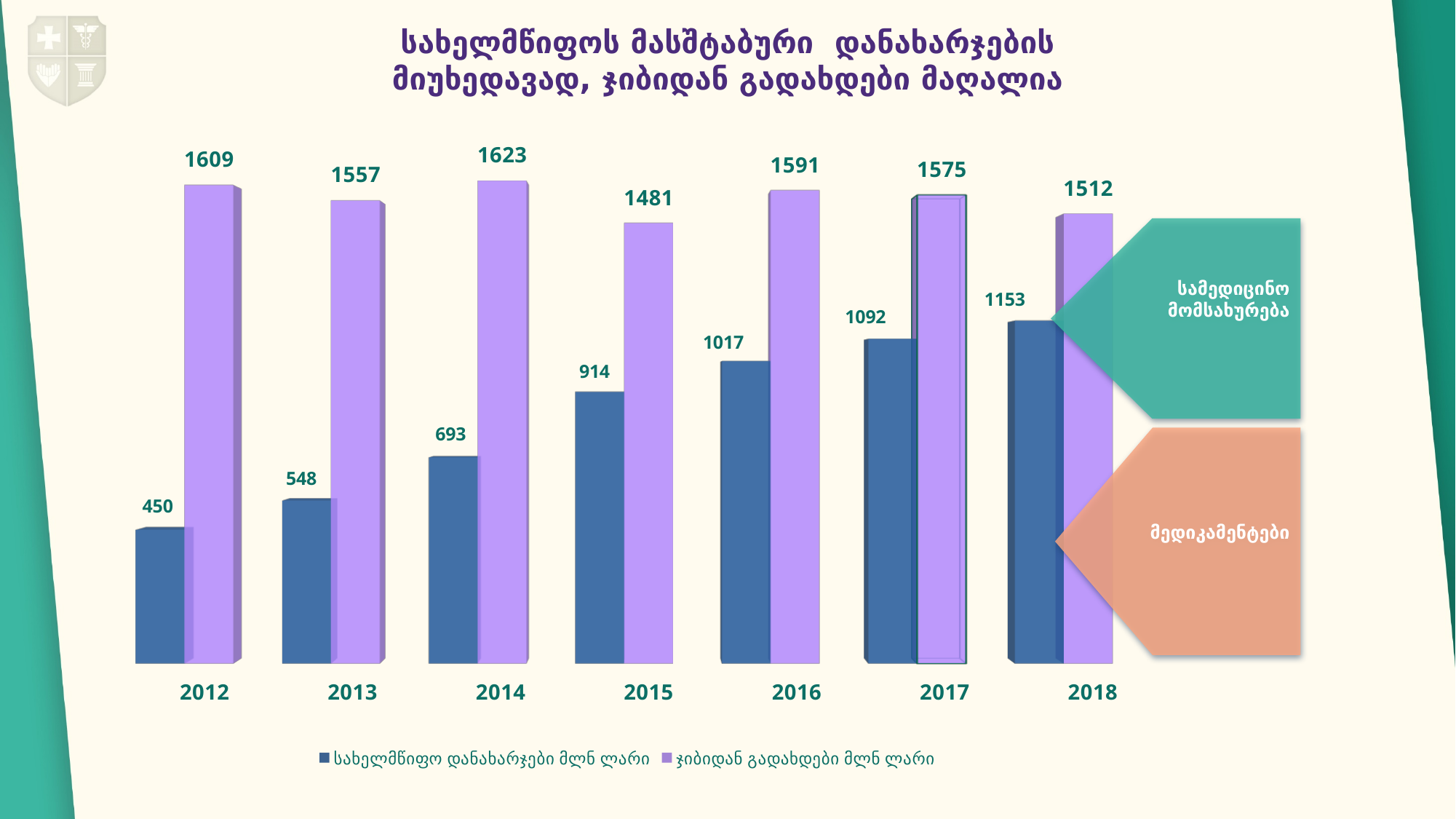
Does the blue series (სახელმწიფო დანახარჯები მლნ ლარი) rise or fall from 2012 to 2018? Rise How many years are shown on the x axis? 7 What is the value of the purple series (ჯიბიდან გადახდები მლნ ლარი) for 2014? 1623 What is the difference between the purple and blue values in 2017? 483 What kind of chart is shown on the slide? Bar chart What is the value of the blue series (სახელმწიფო დანახარჯები მლნ ლარი) for 2018? 1153 How many series does the legend list? 2 What is the value of the blue series (სახელმწიფო დანახარჯები მლნ ლარი) for 2012? 450 In which year is the blue series (სახელმწიფო დანახარჯები მლნ ლარი) lowest? 2012 In which year is the purple series (ჯიბიდან გადახდები მლნ ლარი) highest? 2014 Which is larger in 2015: the blue series value or the purple series value? The purple series (1481) What colour are the bars for ჯიბიდან გადახდები მლნ ლარი? Purple